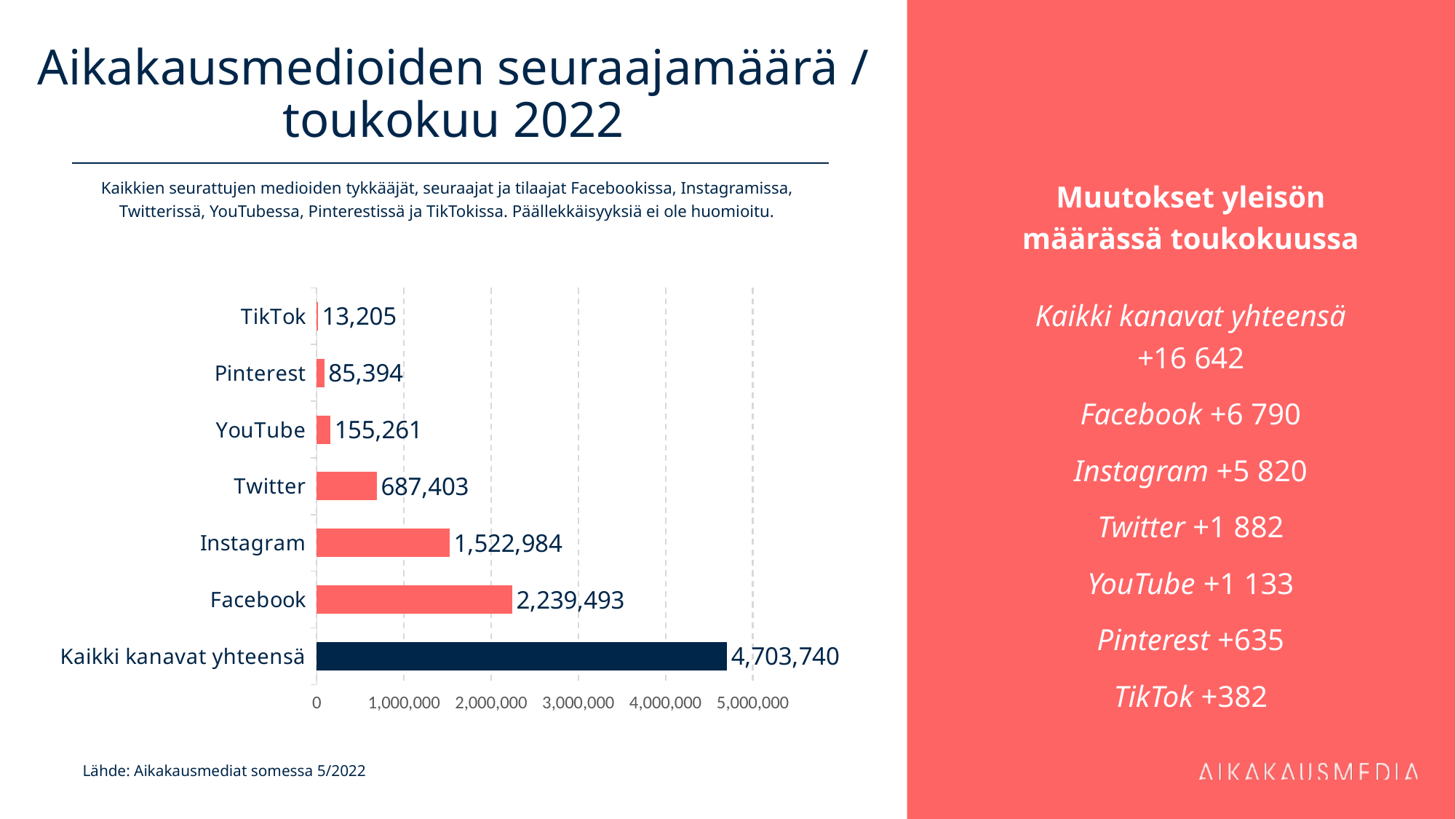
Which category has the highest value? Kaikki kanavat yhteensä Which is larger, the value for Pinterest or the value for YouTube? YouTube What is the difference between the values for Twitter and YouTube? 532,142 What kind of chart is shown on the slide? bar chart What is the value for Kaikki kanavat yhteensä? 4,703,740 How many categories are shown in the chart? 7 What is the value for Instagram? 1,522,984 What is the value for Facebook? 2,239,493 What is the difference between the values for Facebook and Instagram? 716,509 What is the value for TikTok? 13,205 Which category has the lowest value? TikTok What is the title of the slide? Aikakausmedioiden seuraajamäärä / toukokuu 2022